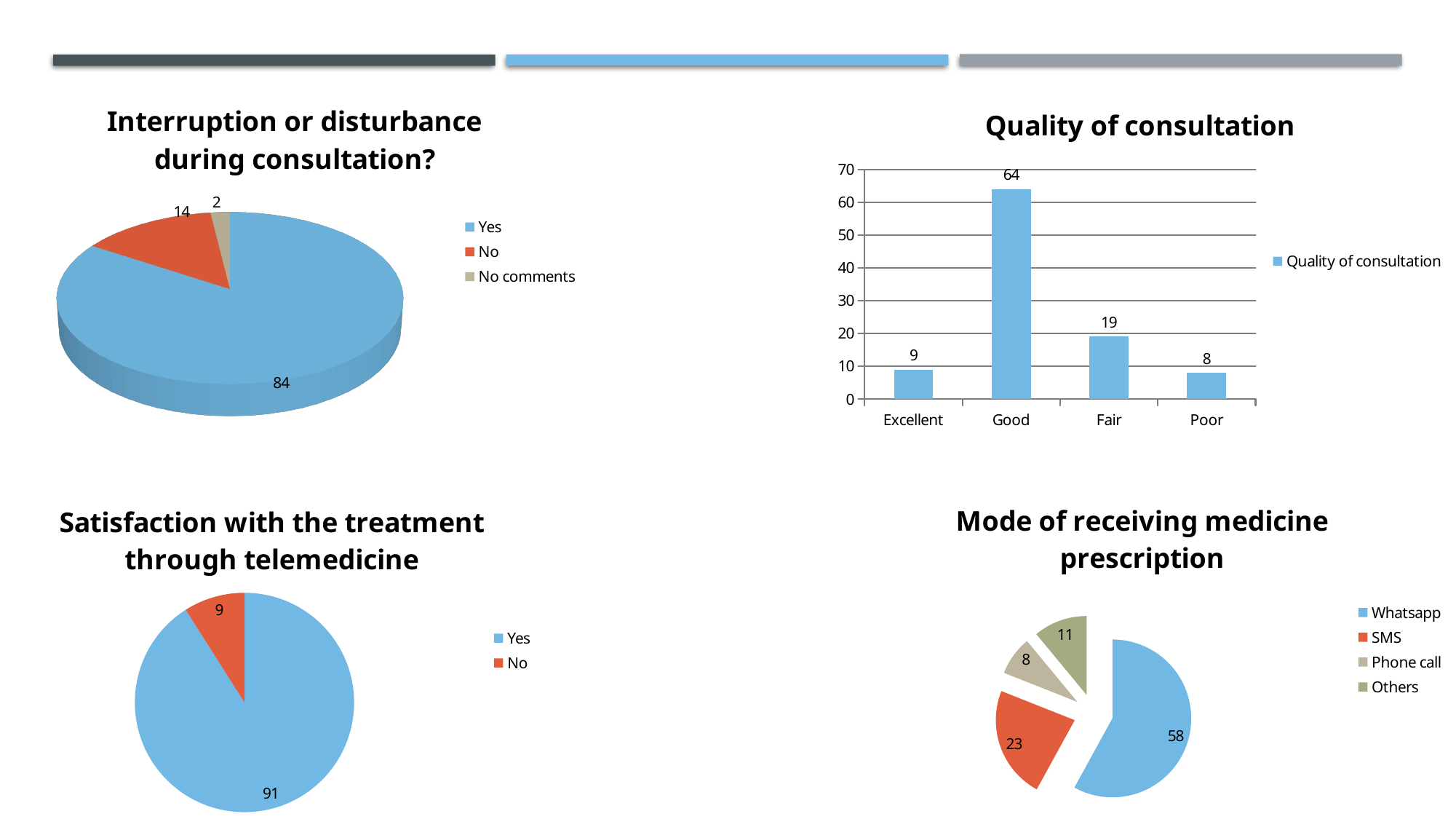
In the 'Interruption or disturbance during consultation?' chart, which slice is the largest? Yes In the 'Quality of consultation' chart, how many categories are shown on the x axis? 4 In the 'Quality of consultation' chart, what is the difference between the values for Good and Fair? 45 In the 'Quality of consultation' chart, which category has the lowest value? Poor In the 'Satisfaction with the treatment through telemedicine' chart, what is the value for No? 9 In the 'Mode of receiving medicine prescription' chart, what is the value for Others? 11 In the 'Interruption or disturbance during consultation?' chart, what is the total of all slices? 100 In the 'Quality of consultation' chart, what is the value for Good? 64 What kind of chart is the 'Quality of consultation' chart? bar chart In the 'Mode of receiving medicine prescription' chart, which is larger, SMS or Phone call? SMS In the 'Interruption or disturbance during consultation?' chart, what is the value for No? 14 In the 'Satisfaction with the treatment through telemedicine' chart, how many entries does the legend list? 2